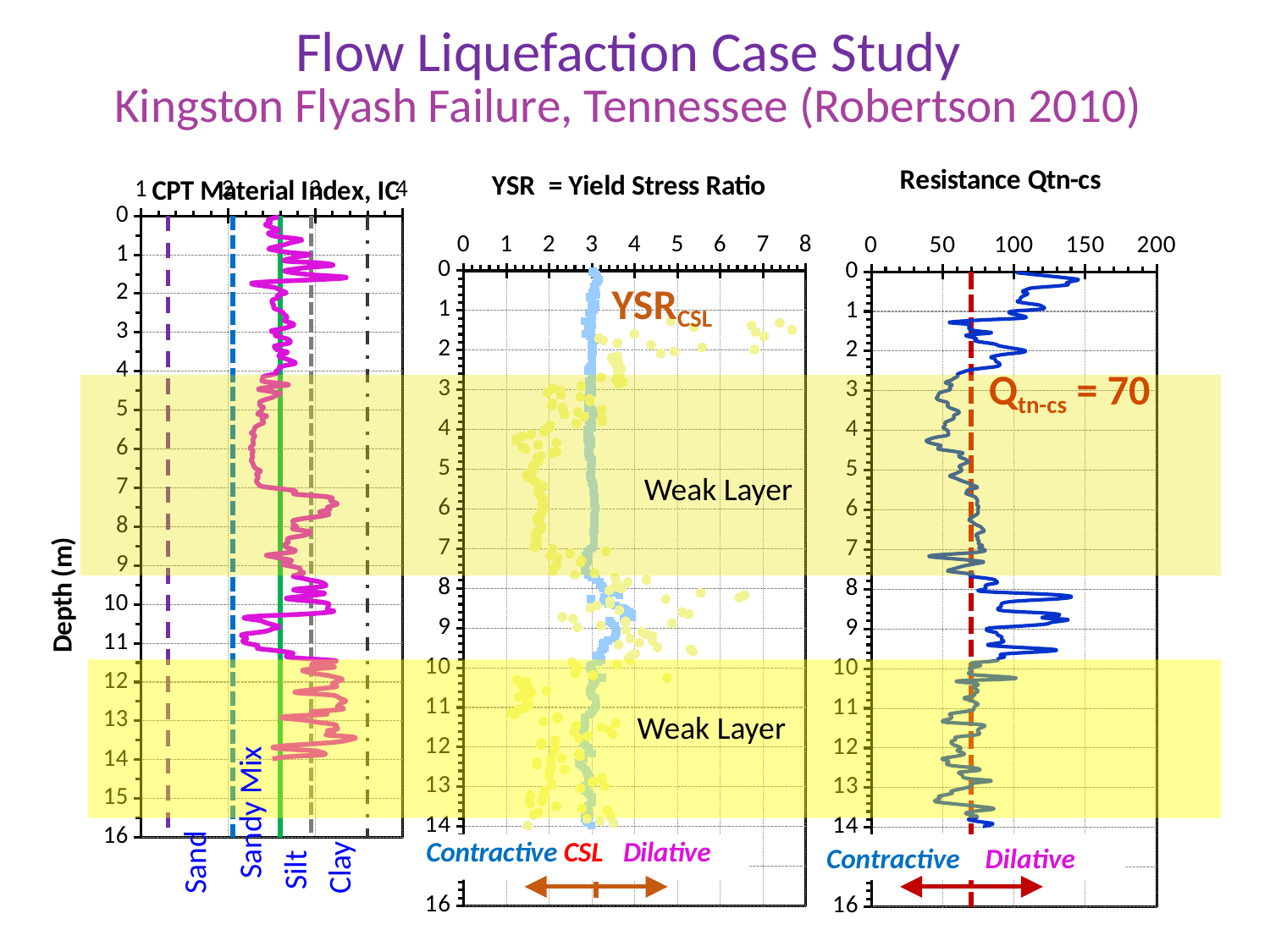
In the YSR = Yield Stress Ratio chart, are the yellow points at depth 5 m greater or less than 3? less What kind of chart is the Resistance Qtn-cs chart on the right? line chart What is the deepest depth value shown on the vertical axis of the CPT Material Index, IC chart? 16 How many soil type labels (Sand, Sandy Mix, Silt, Clay) are shown below the CPT Material Index, IC chart? 4 How many 'Weak Layer' bands are highlighted in yellow across the charts? 2 In the Resistance Qtn-cs chart, is the value at depth 5 m greater or less than 100? less In the Resistance Qtn-cs chart, what Qtn-cs value does the dashed red vertical line mark? 70 What is the maximum value shown on the horizontal axis of the Resistance Qtn-cs chart? 200 What is the maximum value shown on the horizontal axis of the YSR = Yield Stress Ratio chart? 8 What kind of chart is the YSR = Yield Stress Ratio chart in the middle? scatter chart Which of the three charts has the largest maximum value on its horizontal axis? Resistance Qtn-cs